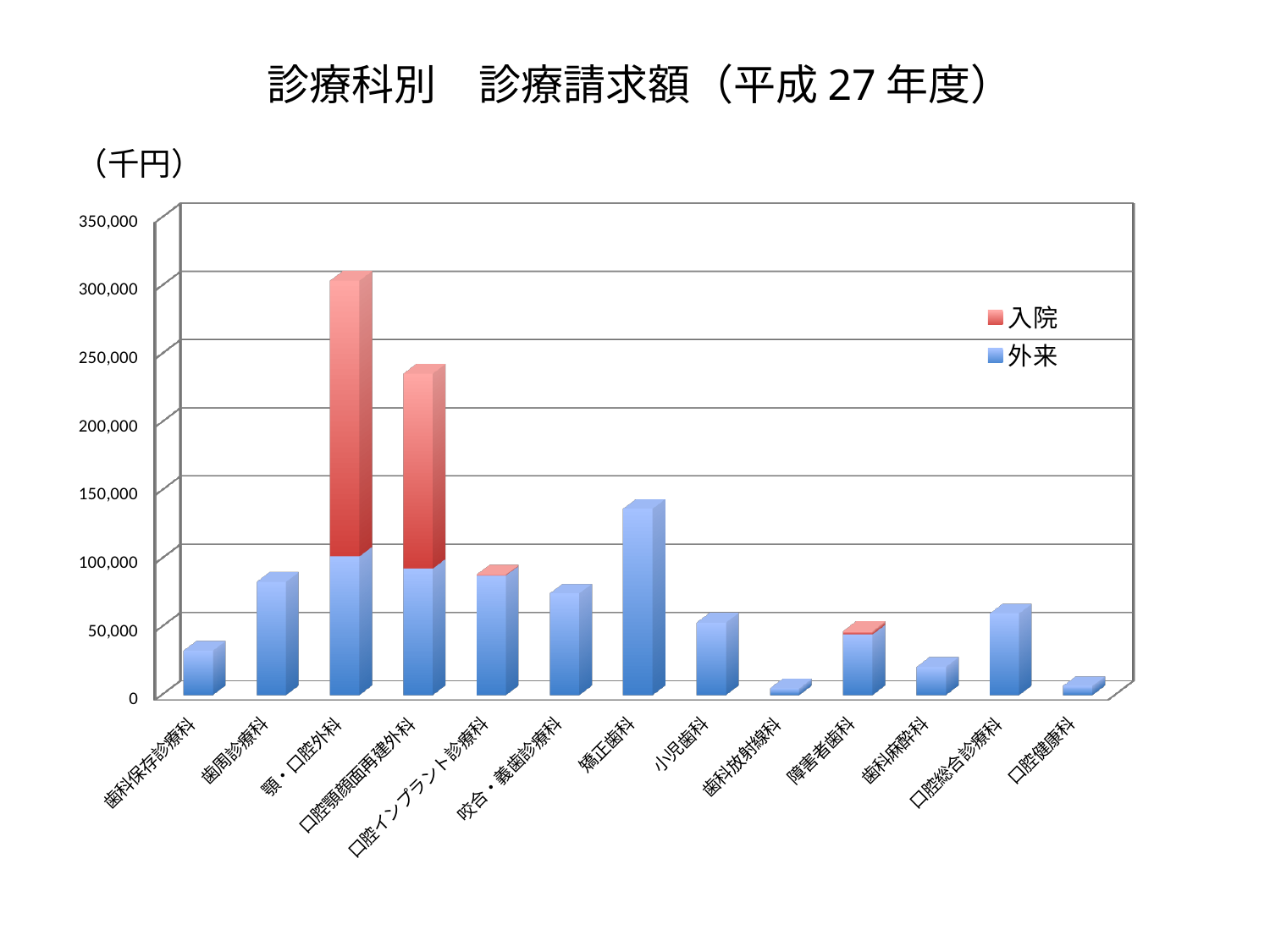
Is the value for 矯正歯科 greater or less than 100,000? greater What unit is indicated above the chart's vertical axis? 千円 What kind of chart is shown on the slide? Stacked bar chart Is the value for 歯科麻酔科 greater or less than 50,000? less Is the total value for 口腔顎顔面再建外科 greater or less than 200,000? greater How many series does the legend list? 2 Which is larger, the value for 矯正歯科 or the value for 小児歯科? 矯正歯科 Which department has the largest 外来 (blue) value? 矯正歯科 Which colour represents 入院 in the legend? Red How many departments (categories) are shown on the x axis? 13 Which department has the highest total 診療請求額? 顎・口腔外科 Which is larger, the total for 顎・口腔外科 or the total for 口腔顎顔面再建外科? 顎・口腔外科